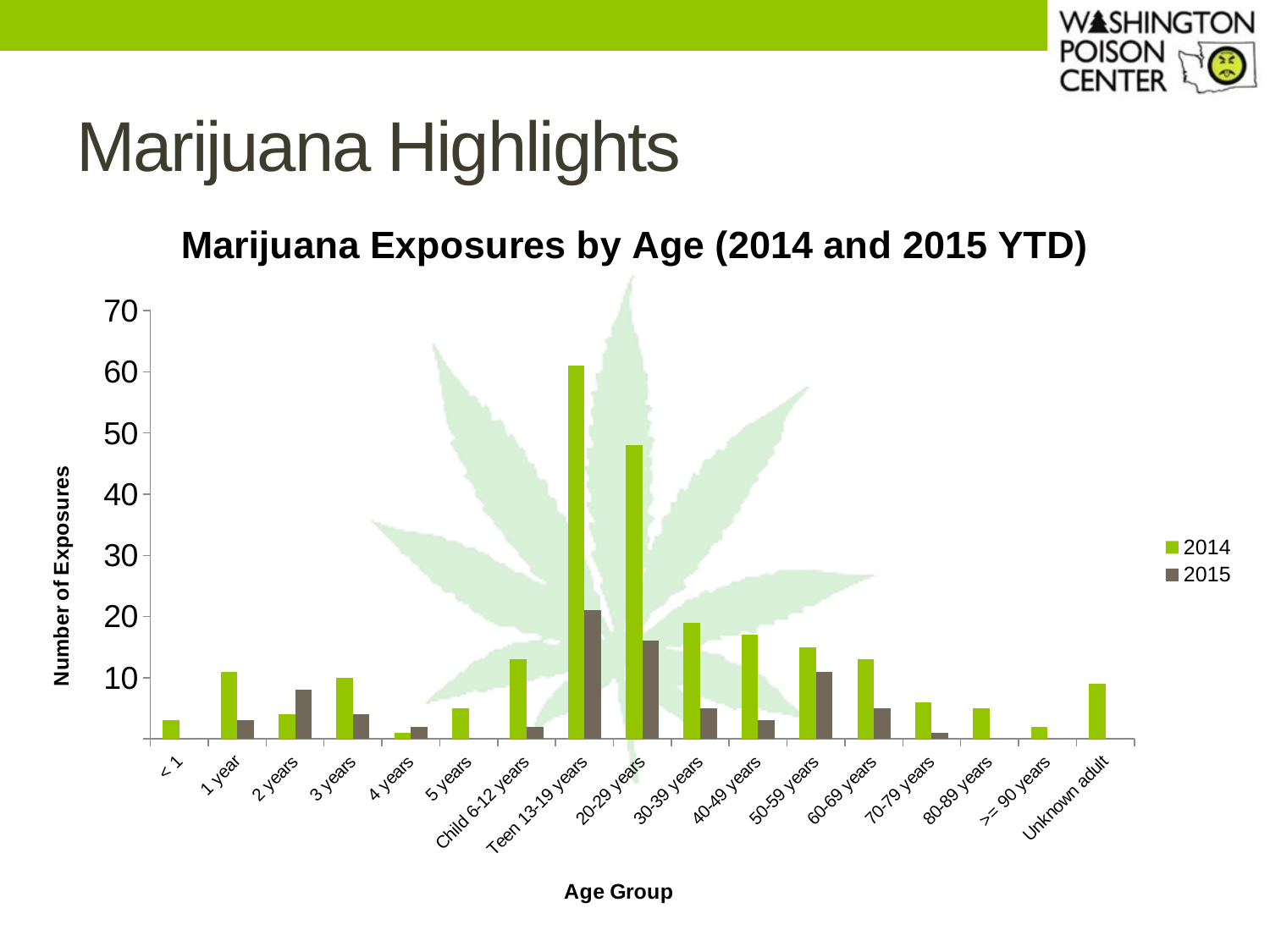
Is the 2015 value for Teen 13-19 years greater or less than 10? greater What is the title of the chart? Marijuana Exposures by Age (2014 and 2015 YTD) How many age group categories are shown on the x axis? 17 For 20-29 years, which series has the larger value, 2014 or 2015? 2014 For 2 years, which series has the larger value, 2014 or 2015? 2015 What kind of chart is shown on the slide? bar chart Which age group has the highest number of exposures for 2014? Teen 13-19 years Is the 2014 value for 20-29 years greater or less than 40? greater Is the 2014 value for 30-39 years greater or less than 10? greater How many series does the legend list? 2 Which age group has the highest number of exposures for 2015? Teen 13-19 years